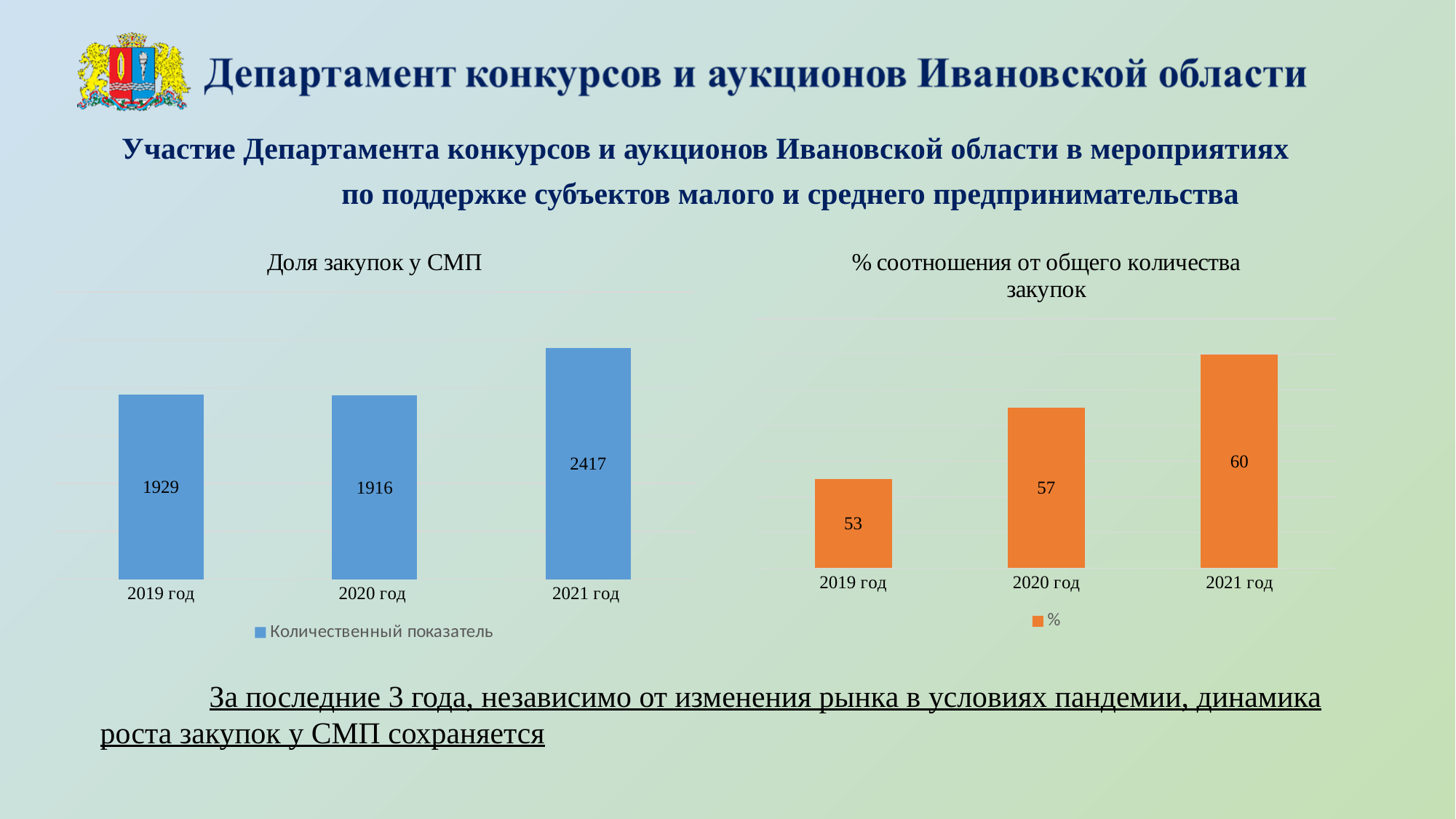
In the chart titled "% соотношения от общего количества закупок", what is the value for 2019 год? 53 In the chart titled "% соотношения от общего количества закупок", which year has the highest value? 2021 год In the chart titled "Доля закупок у СМП", what is the value for 2021 год? 2417 In the chart titled "Доля закупок у СМП", which year has the lowest value? 2020 год In the chart titled "% соотношения от общего количества закупок", do the values rise or fall from 2019 год to 2021 год? rise In the chart titled "Доля закупок у СМП", which year has the highest value? 2021 год How many categories are shown in the chart titled "Доля закупок у СМП"? 3 In the chart titled "Доля закупок у СМП", what is the value for 2019 год? 1929 In the chart titled "% соотношения от общего количества закупок", what is the difference between the values for 2021 год and 2019 год? 7 What type of chart is the chart titled "% соотношения от общего количества закупок"? bar chart In the chart titled "% соотношения от общего количества закупок", what is the value for 2020 год? 57 In the chart titled "Доля закупок у СМП", what is the difference between the values for 2021 год and 2020 год? 501